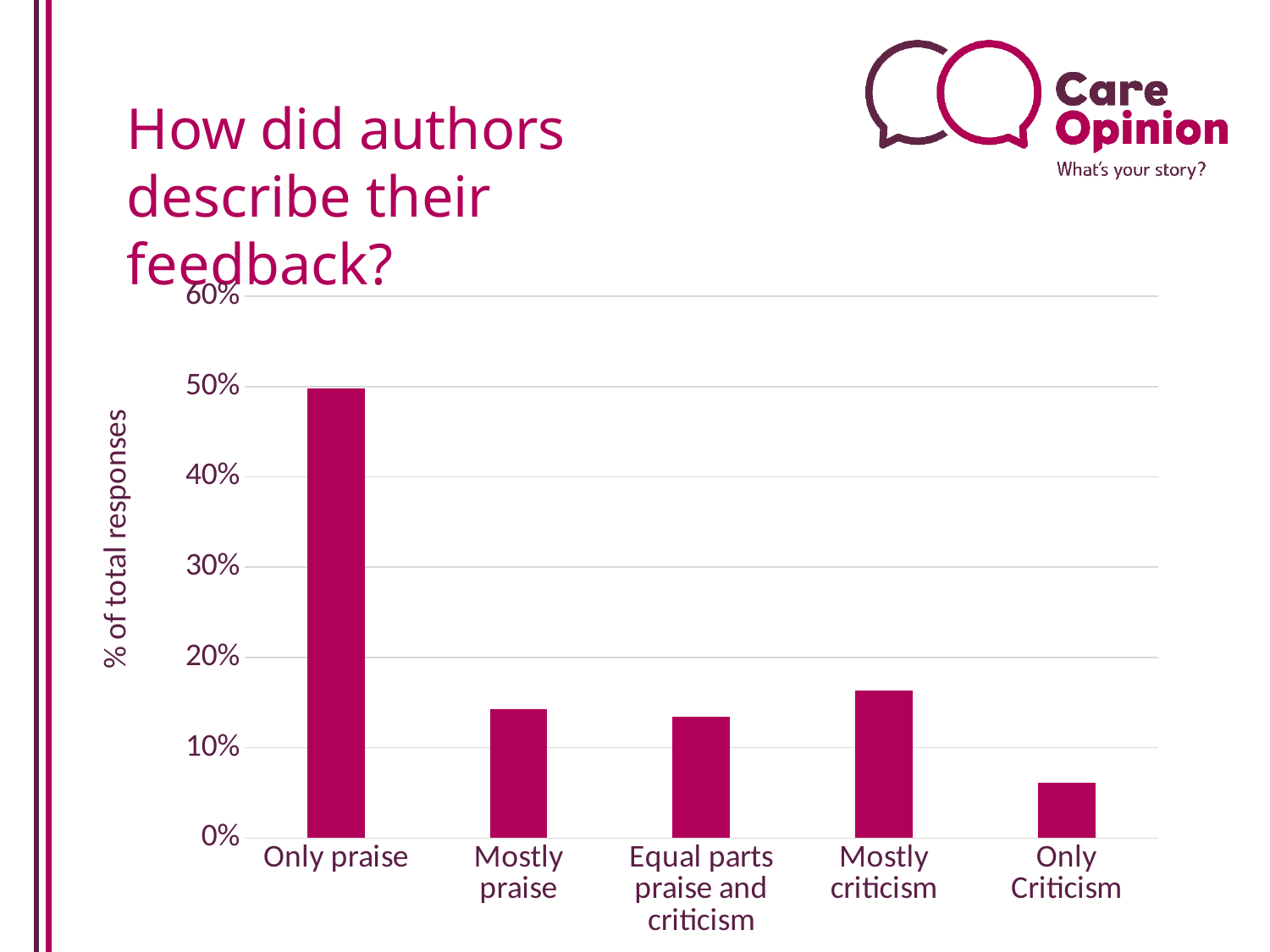
Which is larger, the value for Mostly criticism or the value for Only Criticism? Mostly criticism How many categories are shown on the x axis of the chart? 5 Is the value for Mostly criticism greater or less than 10%? greater What kind of chart is shown on the slide? bar chart Is the value for Equal parts praise and criticism greater or less than 20%? less Which category has the highest value in the chart? Only praise Which is larger, the value for Only praise or the value for Mostly criticism? Only praise What is the label on the vertical axis of the chart? % of total responses Which category has the lowest value in the chart? Only Criticism Is the value for Only Criticism greater or less than 10%? less